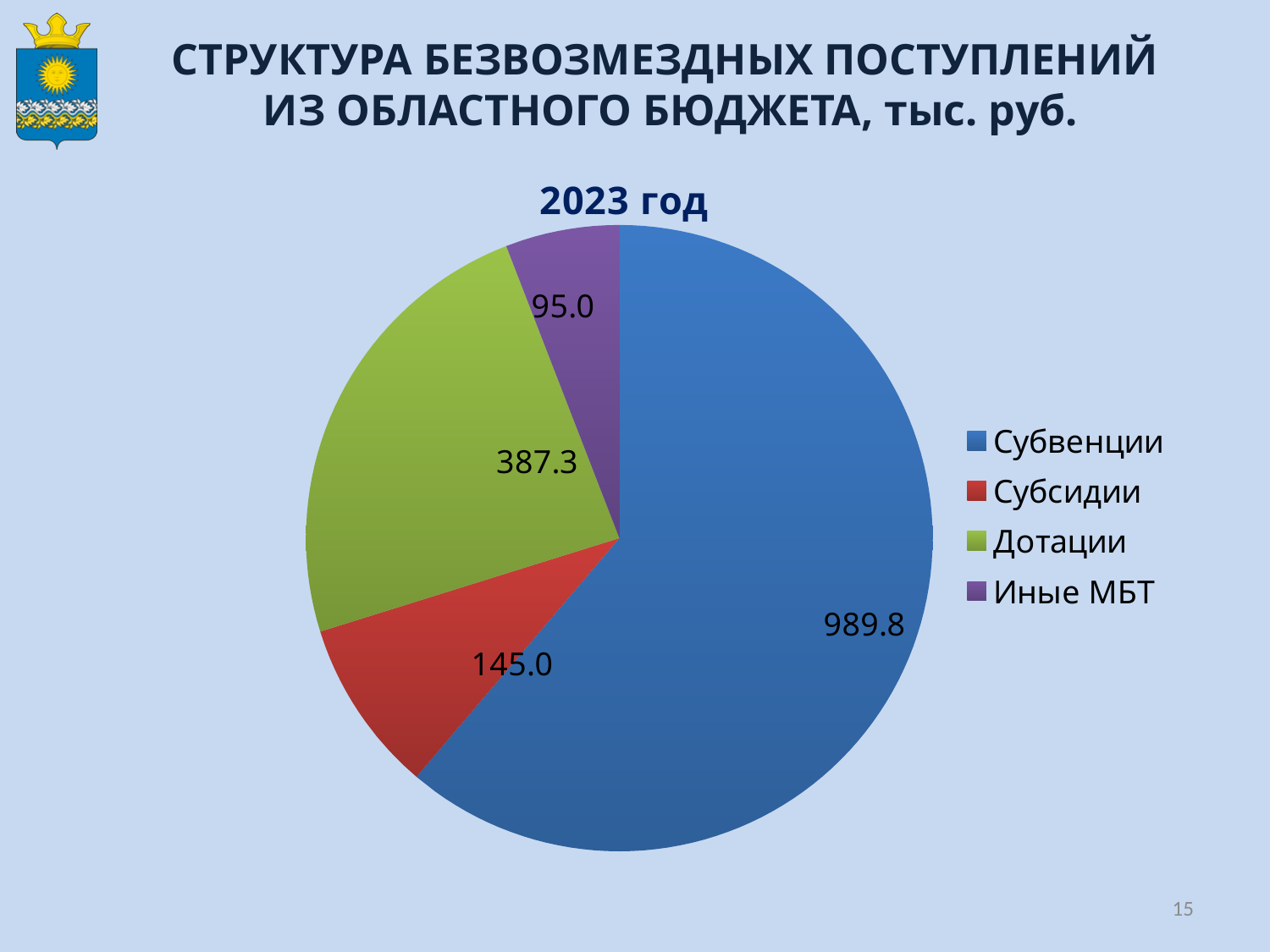
What is the value for Иные МБТ in the 2023 год pie chart? 95.0 What kind of chart is shown on the slide? pie chart What share of the pie does Субвенции represent? 61.2% What is the difference between the values for Субвенции and Дотации? 602.5 What year is shown in the chart title? 2023 год Which category has the largest slice in the pie chart? Субвенции How many categories does the pie chart show? 4 What is the value for Дотации in the 2023 год pie chart? 387.3 Which is larger, Субсидии or Дотации? Дотации Which category has the smallest slice in the pie chart? Иные МБТ What is the value for Субвенции in the 2023 год pie chart? 989.8 What is the value for Субсидии in the 2023 год pie chart? 145.0